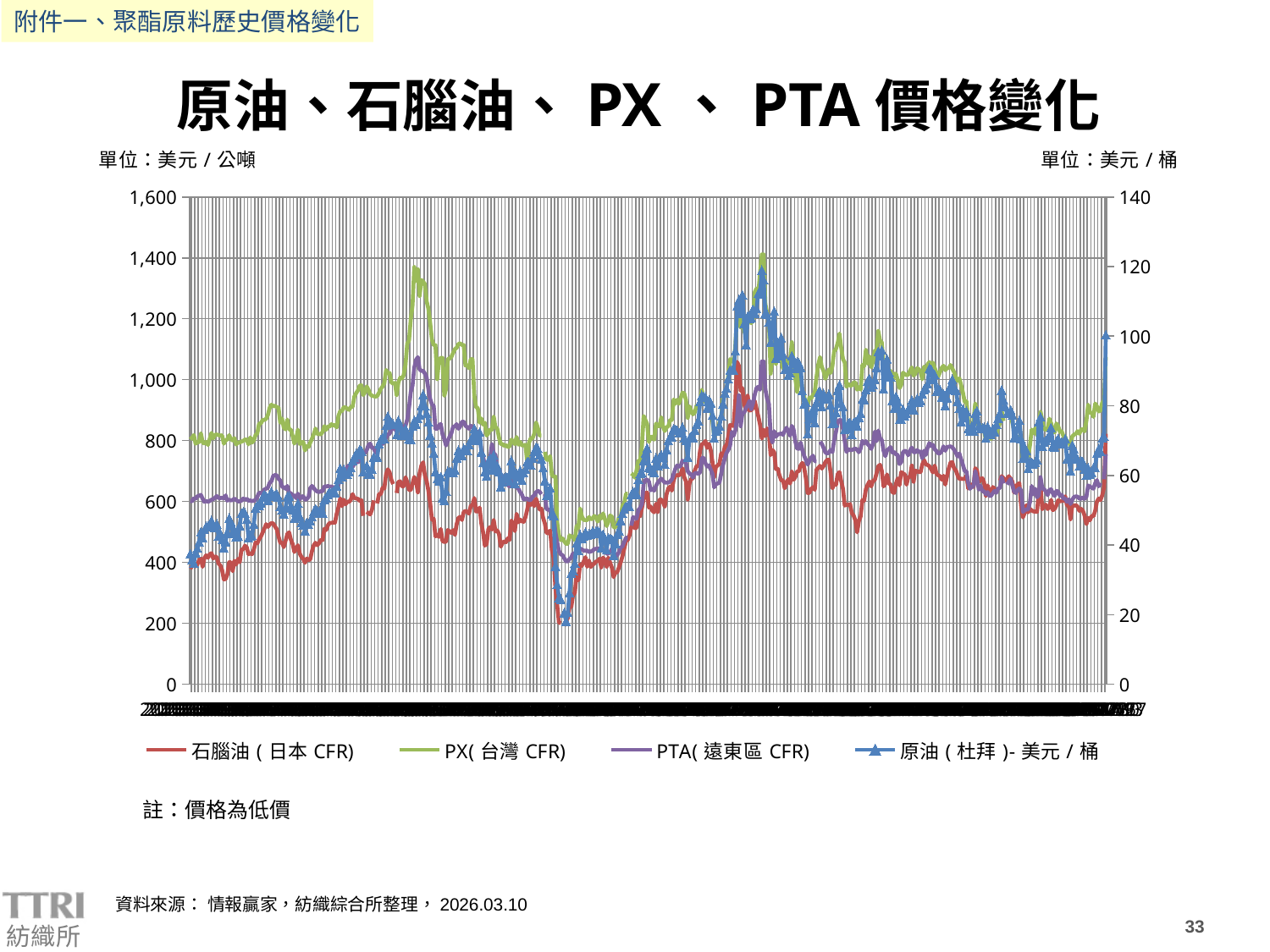
How many series does the legend list? 4 Which series is plotted against the right-hand axis in 美元/桶? 原油 ( 杜拜 )- 美元 / 桶 Is the highest value reached by the 原油 ( 杜拜 ) series greater or less than 100 on the right axis? greater What is the maximum tick value shown on the left vertical axis? 1,600 Among the three series plotted on the left axis (石腦油, PX, PTA), which one is generally the highest across the chart? PX( 台灣 CFR) Is the highest value reached by the PX( 台灣 CFR) series greater or less than 1,200 on the left axis? greater Is the lowest value reached by the 石腦油 ( 日本 CFR) series greater or less than 400 on the left axis? less What is the maximum tick value shown on the right vertical axis? 140 What kind of chart is shown on the slide? Line chart Among the three series plotted on the left axis (石腦油, PX, PTA), which one is generally the lowest across the chart? 石腦油 ( 日本 CFR)